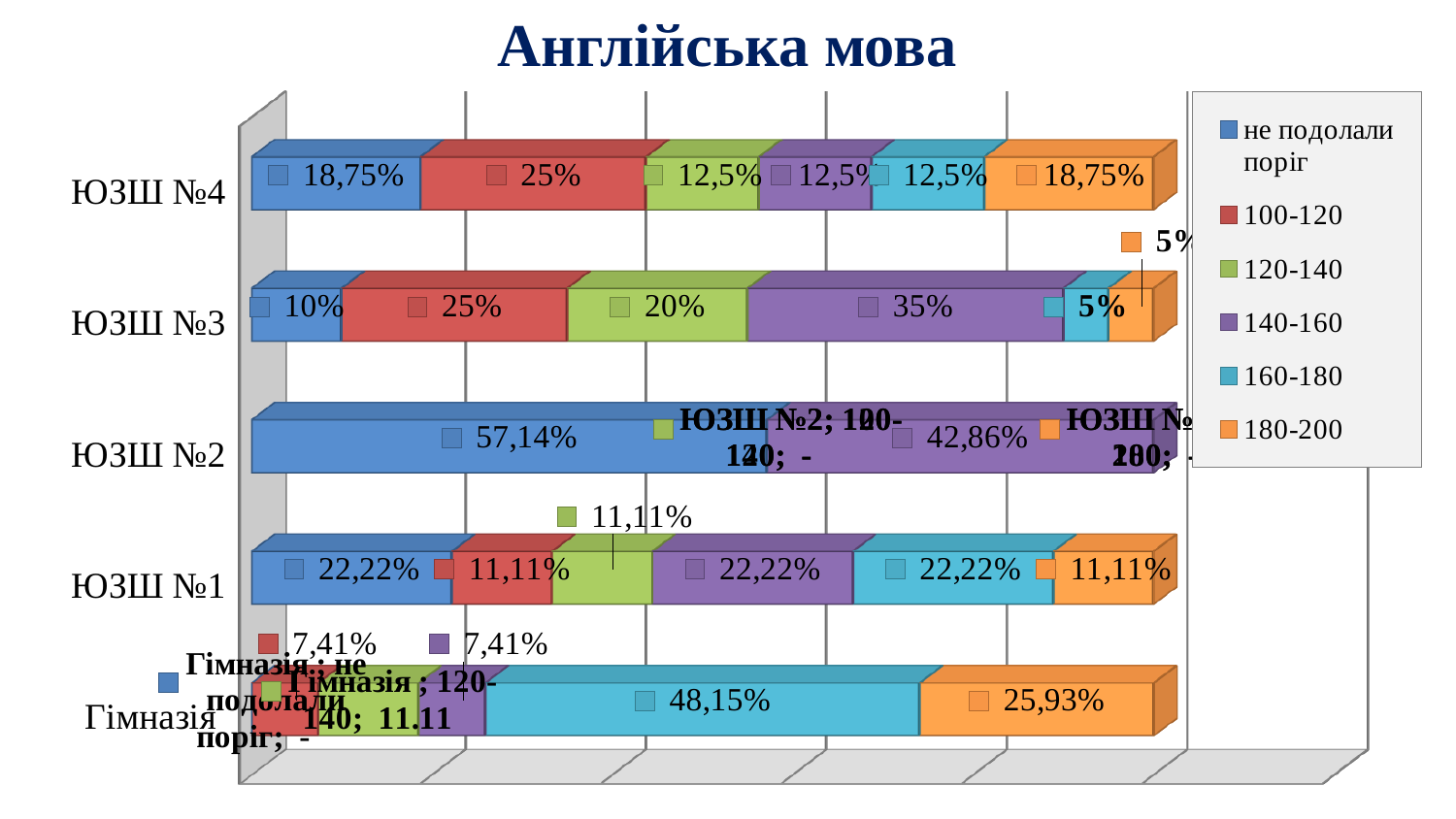
How many schools (categories) are shown on the chart? 5 What is the difference between the 160-180 value for Гімназія and the 180-200 value for Гімназія? 22,22% What kind of chart is shown on the slide? stacked bar chart What is the value of the 140-160 series for ЮЗШ №3? 35% What is the title of the chart? Англійська мова What is the value of the 180-200 series for ЮЗШ №1? 11,11% What is the value of the 100-120 series for ЮЗШ №4? 25% How many series does the legend list? 6 What is the value of the 160-180 series for Гімназія? 48,15% Which school has the highest value for the 'не подолали поріг' series? ЮЗШ №2 What is the value of the 'не подолали поріг' series for ЮЗШ №2? 57,14%